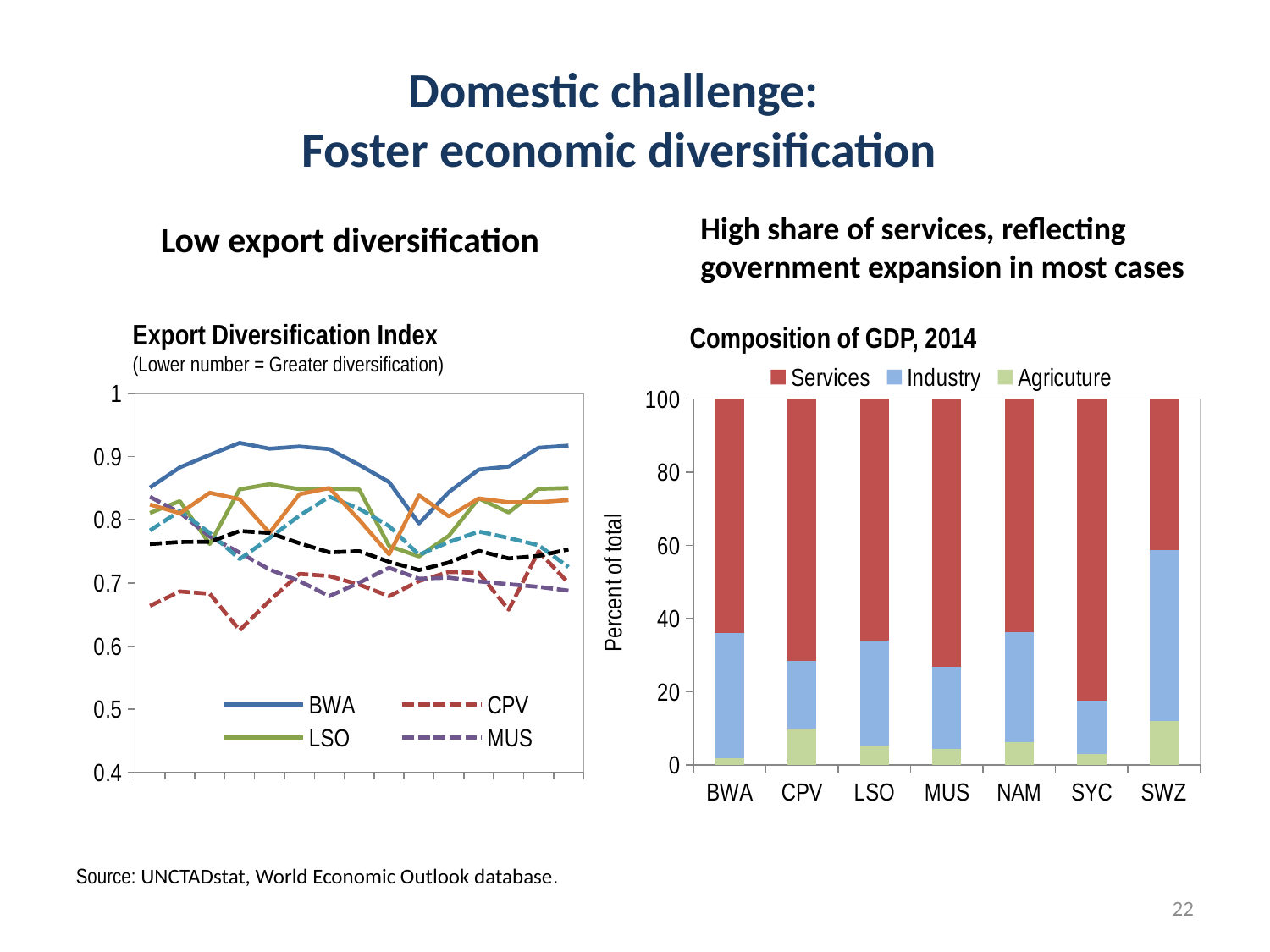
How many countries are shown on the x axis of the Composition of GDP, 2014 chart? 7 How many series does the legend of the Export Diversification Index chart list? 4 How many series does the legend of the Composition of GDP, 2014 chart list? 3 In the Composition of GDP, 2014 chart, which country has the largest Services share? SYC In the Composition of GDP, 2014 chart, which country has the largest Industry share? SWZ In the Composition of GDP, 2014 chart, is the Industry share for SWZ greater or less than 40? greater In the Export Diversification Index chart, does the CPV line stay above or below 0.8 throughout? below In the Export Diversification Index chart, which legend series has the highest values across the period? BWA In the Composition of GDP, 2014 chart, is the Industry share for BWA greater or less than 40? less What kind of chart is the Composition of GDP, 2014 chart on the right? stacked bar chart In the Composition of GDP, 2014 chart, which country has the smallest Services share? SWZ What kind of chart is the Export Diversification Index chart on the left? line chart